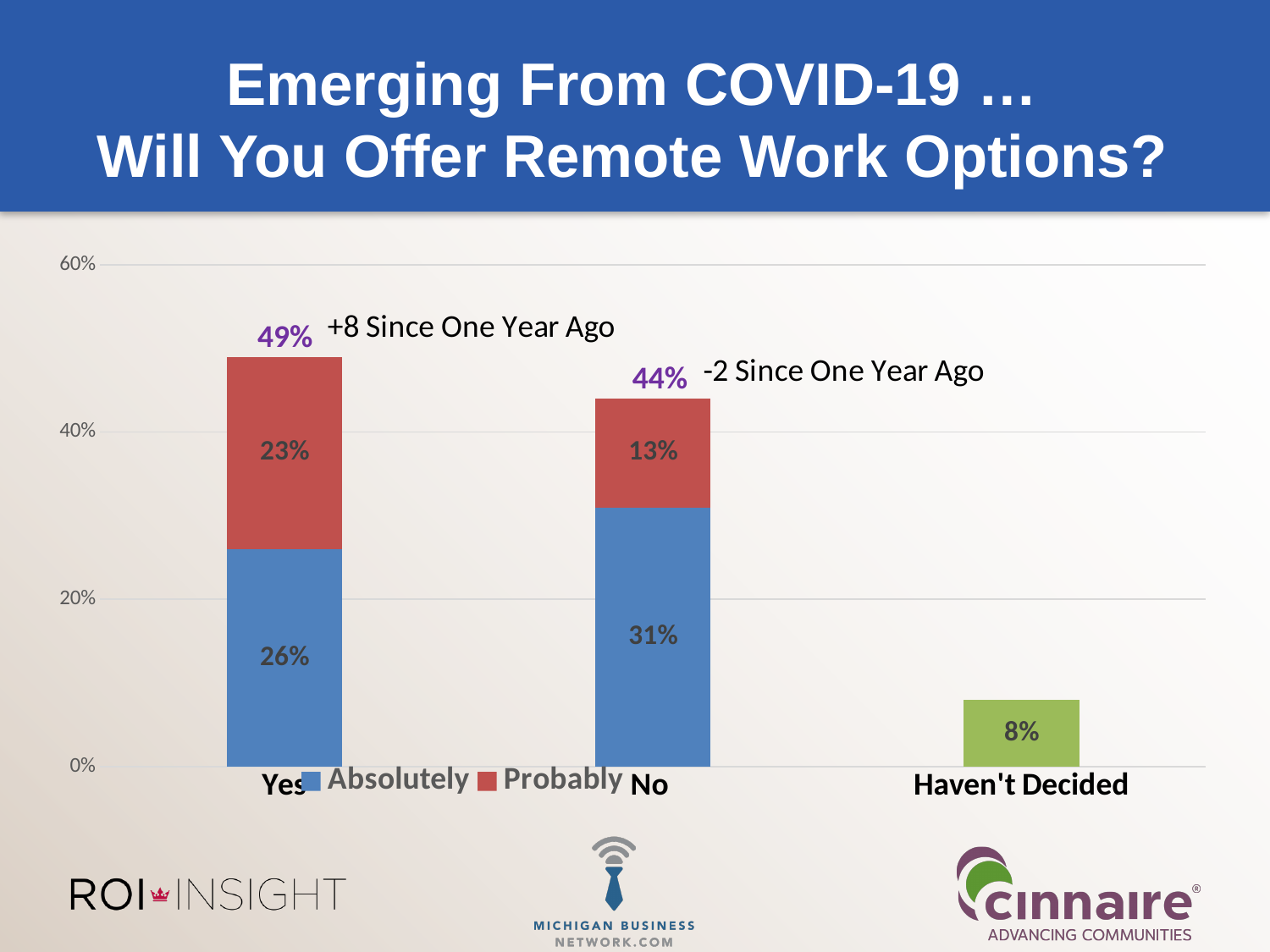
What is the Absolutely value for the Yes category? 26% How many series does the legend list? 2 Which is larger, the Probably value for Yes or the Probably value for No? Yes What is the total of the stacked bar for No? 44% What is the value shown for Haven't Decided? 8% What is the Probably value for the No category? 13% Which category has the lowest value? Haven't Decided How many categories are shown on the x axis? 3 Which category has the highest total? Yes What kind of chart is shown on the slide? Stacked bar chart What is the total of the stacked bar for Yes? 49% What is the difference between the Absolutely values for No and Yes? 5%